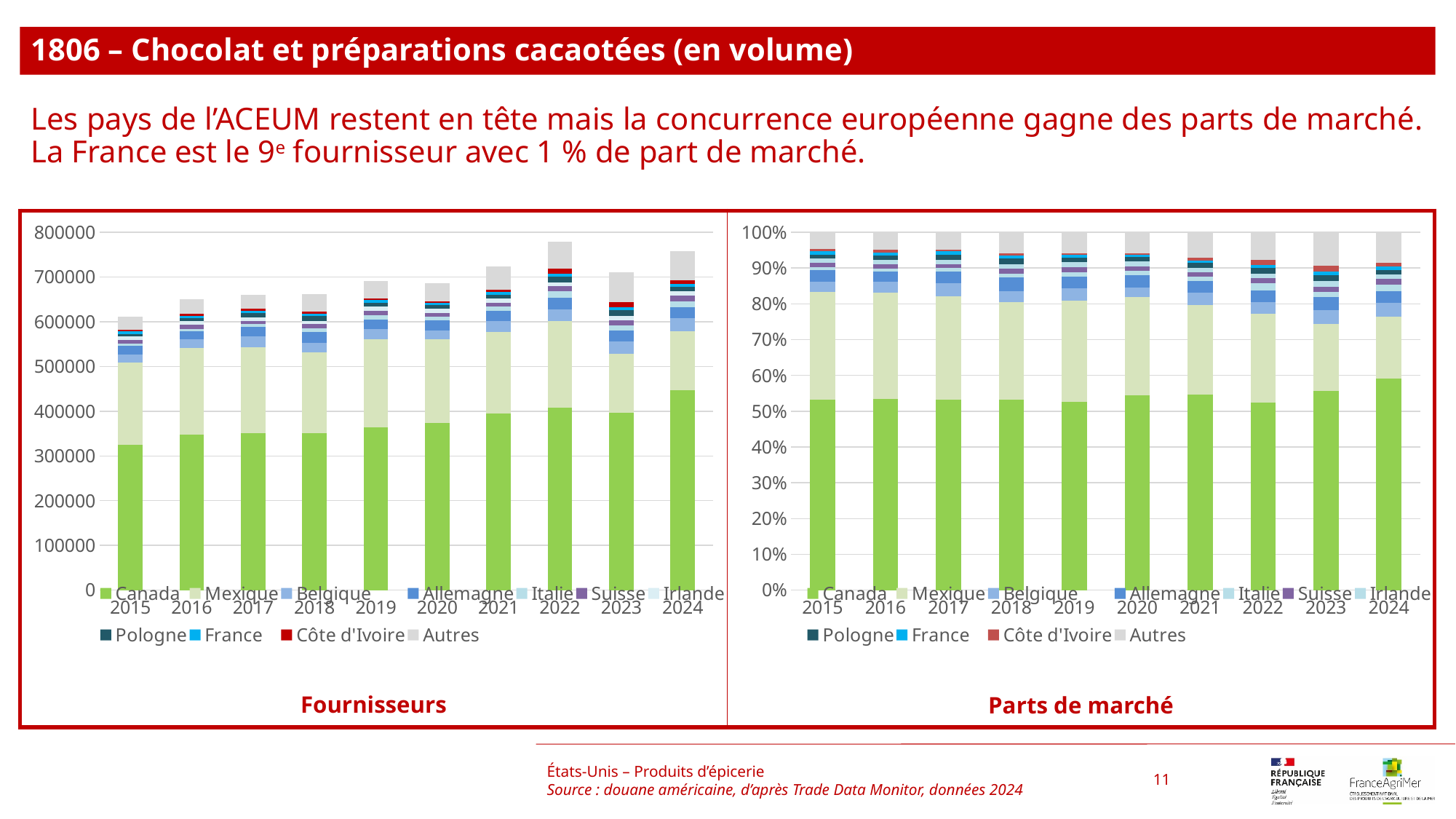
In the 'Fournisseurs' chart, is the Canada value for 2015 greater or less than 400000? less In the 'Fournisseurs' chart, does the Canada segment generally rise or fall from 2015 to 2024? rise How many years are shown on the x axis of the 'Parts de marché' chart? 10 In the 'Fournisseurs' chart, is the Canada value for 2024 greater or less than 400000? greater In the 'Fournisseurs' chart, which year has the tallest total bar? 2022 In the 'Parts de marché' chart, is Canada's share in 2024 greater or less than 50%? greater What kind of chart is the 'Fournisseurs' chart on the left? Stacked bar chart In the 'Fournisseurs' chart, which year has the shortest total bar? 2015 How many series does the legend of the 'Fournisseurs' chart list? 11 Which series is shown in bright green in both charts? Canada